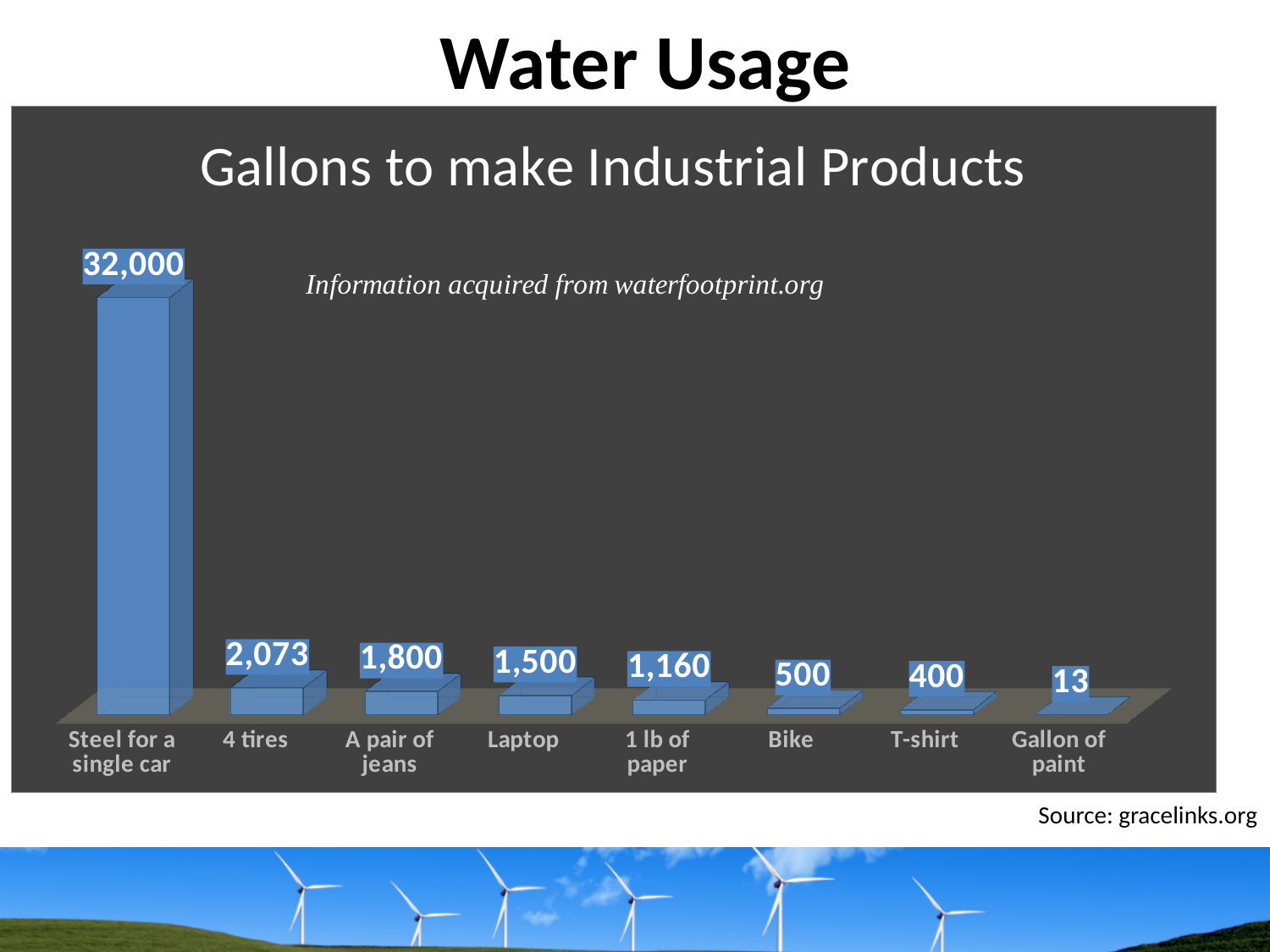
What is the value shown for a laptop? 1,500 How many gallons are needed to make 1 lb of paper? 1,160 How many products are shown in the chart? 8 What is the difference in gallons between a bike and a T-shirt? 100 What is the difference in gallons between 4 tires and a pair of jeans? 273 How many gallons of water does it take to make the steel for a single car? 32,000 What type of chart is shown on the slide? Bar chart Which requires more water to make, a laptop or a pair of jeans? A pair of jeans What is the title of the chart? Gallons to make Industrial Products Which product requires the most gallons of water to make? Steel for a single car What is the value shown for a gallon of paint? 13 Which product requires the fewest gallons of water to make? Gallon of paint